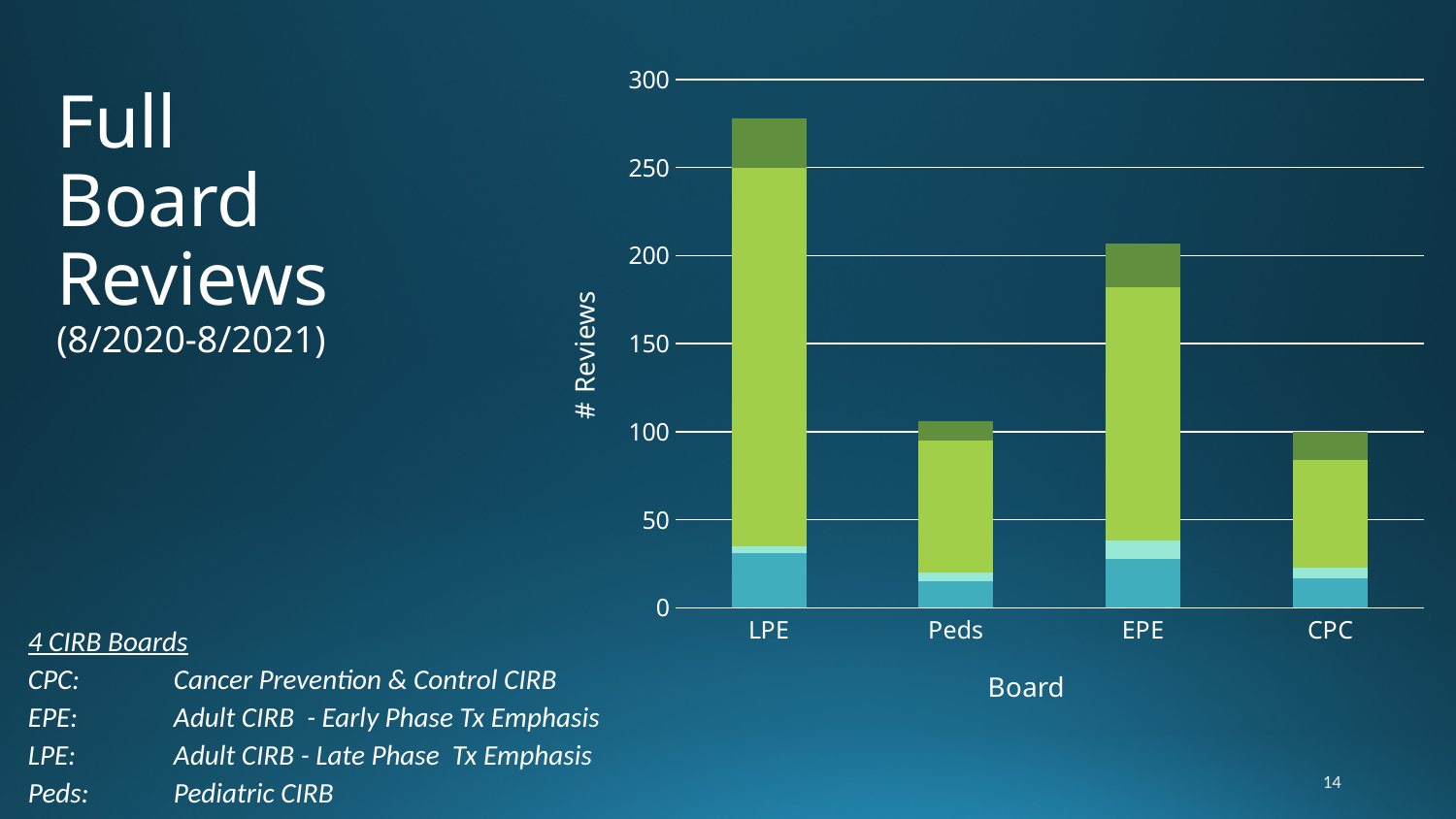
Is the total number of reviews for CPC greater or less than 150? less Which has more total reviews, EPE or Peds? EPE How many boards are shown on the x axis of the chart? 4 Is the total number of reviews for Peds greater or less than 150? less Which has more total reviews, LPE or EPE? LPE Is the total number of reviews for LPE greater or less than 250? greater What is the title of the vertical axis of the chart? # Reviews What kind of chart is shown on the slide? stacked bar chart What is the title of the horizontal axis of the chart? Board Which board has the highest total number of reviews? LPE